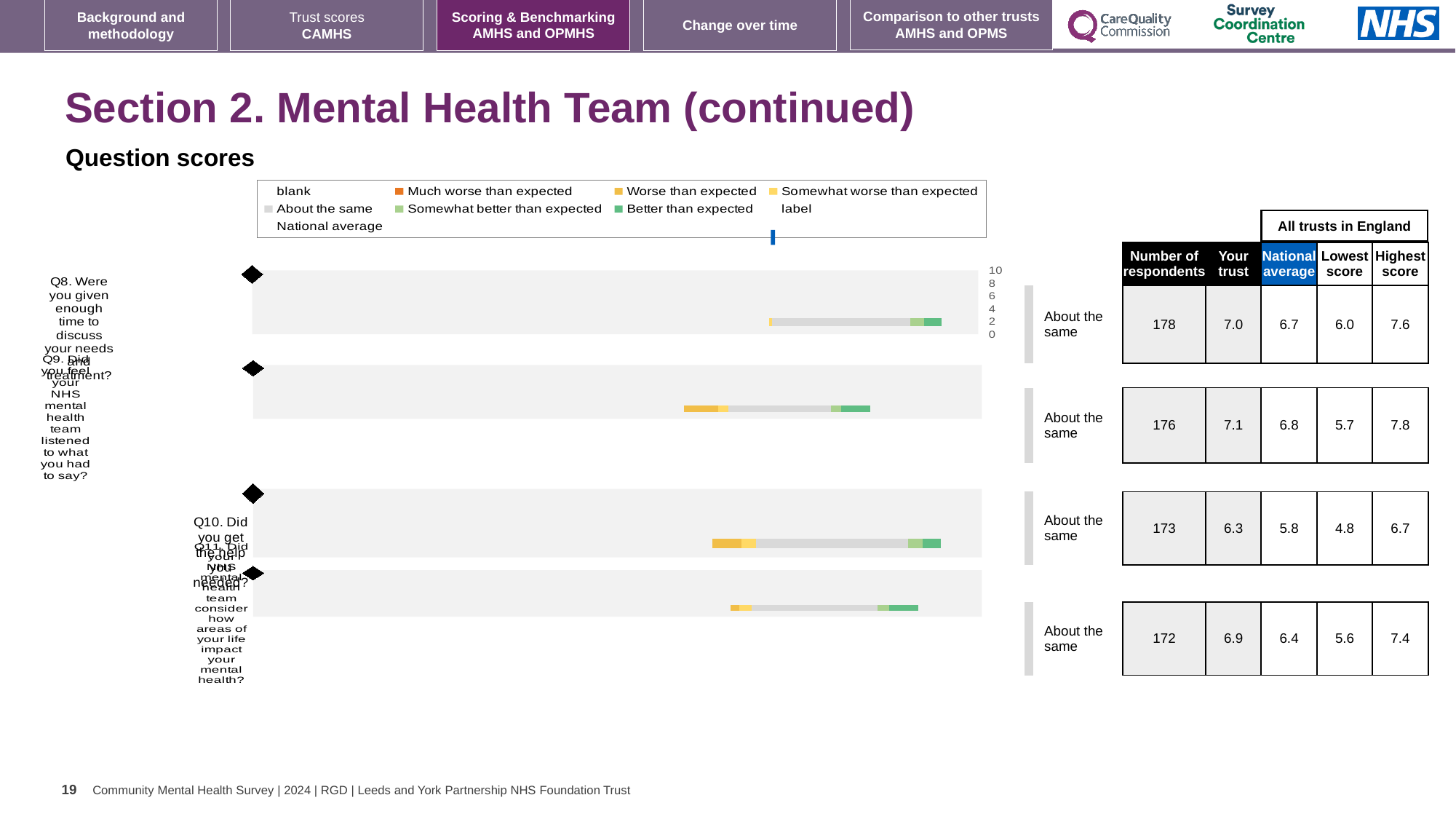
Which question has the lowest 'Your trust' score? Q10 What is the national average score for Q9 (Did you feel your NHS mental health team listened to what you had to say?)? 6.8 What benchmark category is shown for Q11 (Did your NHS mental health team consider how areas of your life impact your mental health?)? About the same What is the difference between the 'Your trust' score and the national average for Q8? 0.3 What is the 'Your trust' score for Q8 (Were you given enough time to discuss your needs and treatment?)? 7.0 For Q10, which is larger: the 'Your trust' score or the national average? Your trust Which question has the highest 'Your trust' score? Q9 Which legend entry is shown in the darkest green colour? Better than expected What kind of chart is used to show the question scores on this slide? bar chart How many questions (Q8 to Q11) are plotted in the question scores chart? 4 How many respondents answered Q10 (Did you get the help you needed?)? 173 What is the highest score among all trusts in England for Q11? 7.4